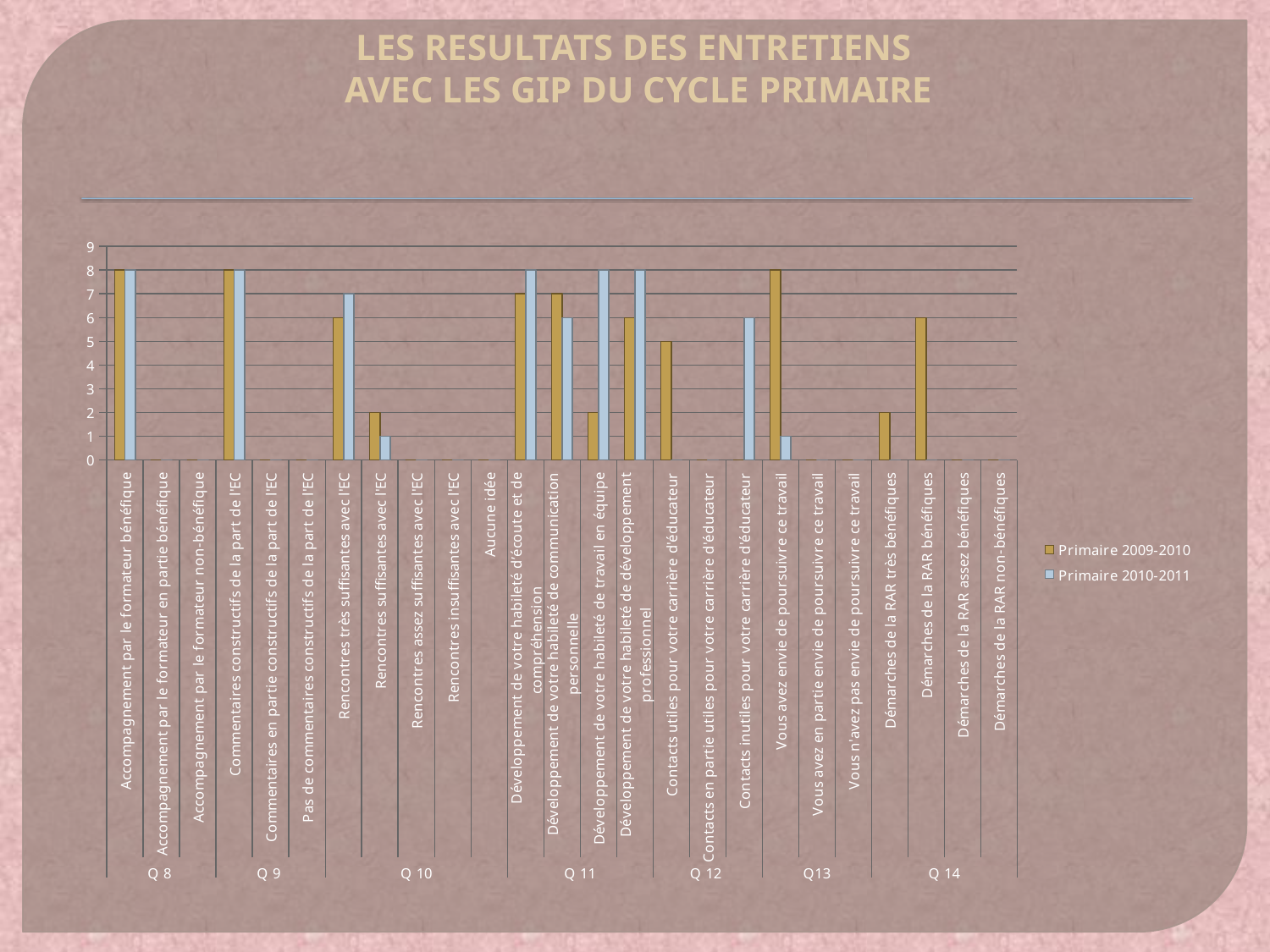
What is the difference between the Primaire 2009-2010 and Primaire 2010-2011 values for 'Vous avez envie de poursuivre ce travail'? 7 What is the difference between the Primaire 2010-2011 and Primaire 2009-2010 values for 'Développement de votre habileté de travail en équipe'? 6 Is the Primaire 2009-2010 value for 'Rencontres suffisantes avec l'EC' greater or less than 5? less How many question groups (Q 8 to Q 14) are labelled along the x axis? 7 What is the value for 'Démarches de la RAR bénéfiques' in the Primaire 2009-2010 series? 6 What is the value for 'Contacts inutiles pour votre carrière d'éducateur' in the Primaire 2010-2011 series? 6 For 'Développement de votre habileté de travail en équipe', which series has the larger value, Primaire 2009-2010 or Primaire 2010-2011? Primaire 2010-2011 How many series does the legend list? 2 What is the value for 'Rencontres très suffisantes avec l'EC' in the Primaire 2010-2011 series? 7 What are the two series named in the legend? Primaire 2009-2010 and Primaire 2010-2011 What is the value for 'Contacts utiles pour votre carrière d'éducateur' in the Primaire 2009-2010 series? 5 What kind of chart is shown on the slide? bar chart